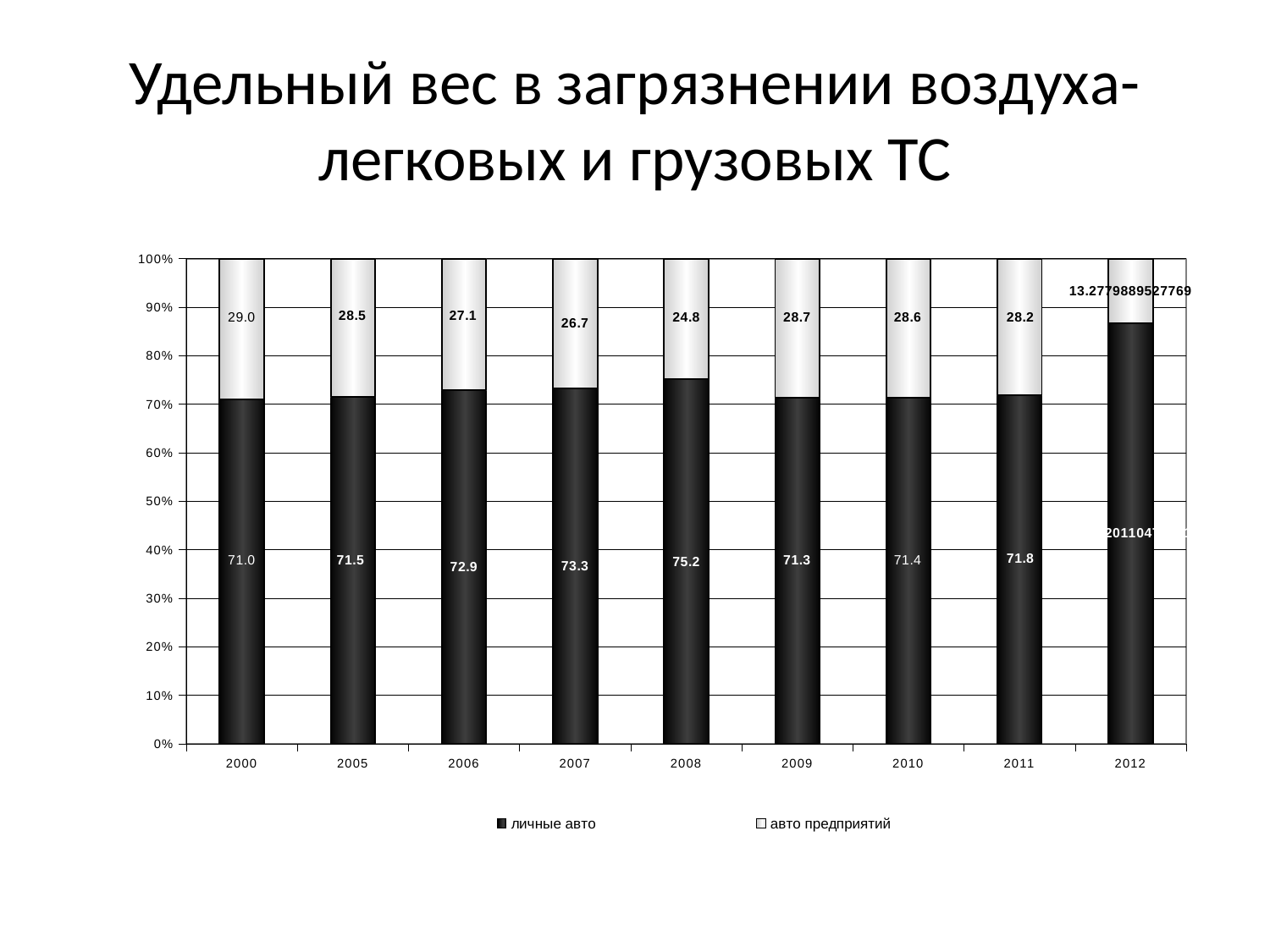
Is the value for личные авто in 2012 greater or less than 80%? greater How many series does the legend list? 2 What kind of chart is shown on the slide? stacked bar chart What is the difference between the личные авто values for 2008 and 2000? 4.2 Which year has the lowest value for авто предприятий? 2012 Which year has the highest value for личные авто? 2012 What is the value for авто предприятий in 2000? 29.0 Which is larger, the авто предприятий value for 2009 or for 2011? 2009 What is the value for авто предприятий in 2007? 26.7 What is the value for личные авто in 2008? 75.2 What is the value for личные авто in 2006? 72.9 How many years are shown on the x axis? 9